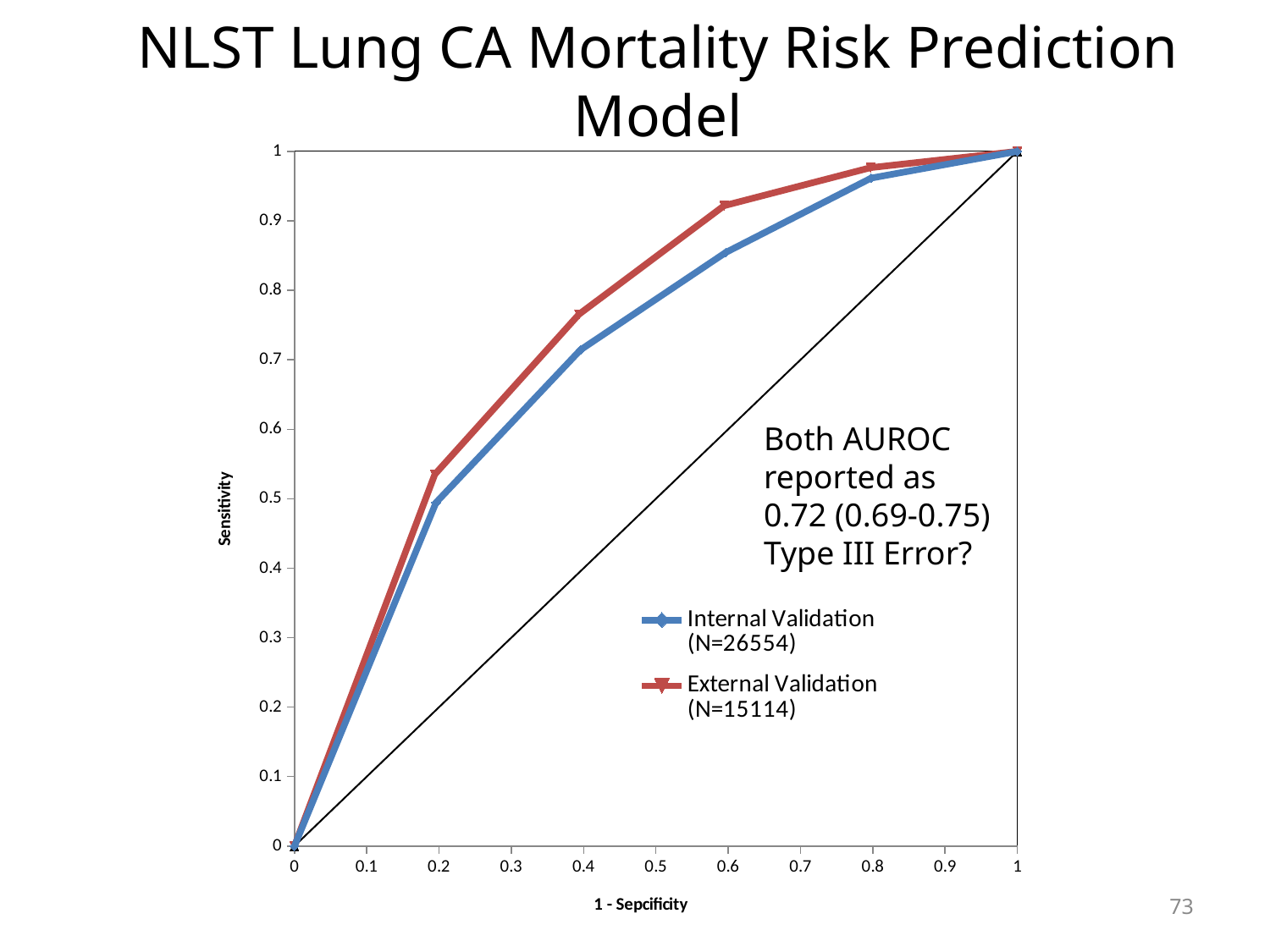
How many series does the legend list? 2 Which series is drawn in red? External Validation (N=15114) Is the Sensitivity value for Internal Validation (N=26554) at 1 - Sepcificity of about 0.4 greater or less than 0.8? less What kind of chart is shown on the slide? line chart Is the Sensitivity value for External Validation (N=15114) at 1 - Sepcificity of about 0.4 greater or less than 0.7? greater At 1 - Sepcificity of about 0.4, which series has the higher Sensitivity, Internal Validation (N=26554) or External Validation (N=15114)? External Validation (N=15114) Is the Sensitivity value for External Validation (N=15114) at 1 - Sepcificity of about 0.6 greater or less than 0.9? greater Do the Sensitivity values for External Validation (N=15114) rise or fall as 1 - Sepcificity increases? rise What is the label of the y axis? Sensitivity What is the label of the x axis? 1 - Sepcificity